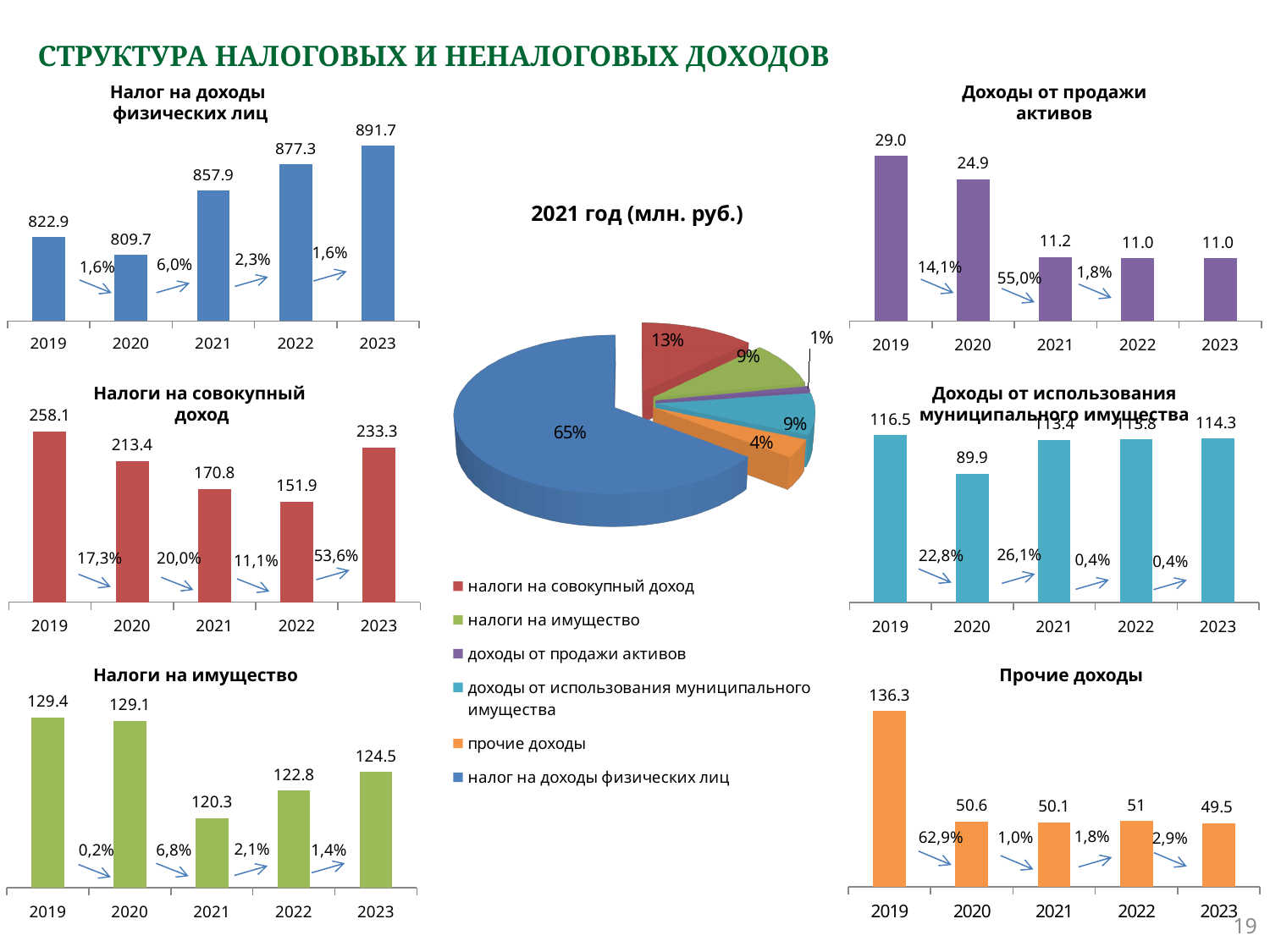
In the chart titled "Налоги на совокупный доход", what is the value for 2022? 151.9 In the pie chart titled "2021 год (млн. руб.)", how many entries does the legend list? 6 In the chart titled "Налог на доходы физических лиц", what is the value for 2023? 891.7 In the chart titled "Доходы от продажи активов", do the values generally rise or fall from 2019 to 2023? fall What kind of chart is the one titled "Доходы от использования муниципального имущества"? bar chart In the chart titled "Налог на доходы физических лиц", which year has the lowest value? 2020 In the chart titled "Прочие доходы", which is larger, the value for 2019 or the value for 2020? 2019 In the chart titled "Налоги на совокупный доход", what is the difference between the 2019 value and the 2023 value? 24.8 In the chart titled "Налоги на имущество", how many years are shown on the x axis? 5 In the chart titled "Доходы от продажи активов", what is the value for 2020? 24.9 In the chart titled "Налоги на имущество", which year has the highest value? 2019 In the pie chart titled "2021 год (млн. руб.)", what share does "налог на доходы физических лиц" have? 65%